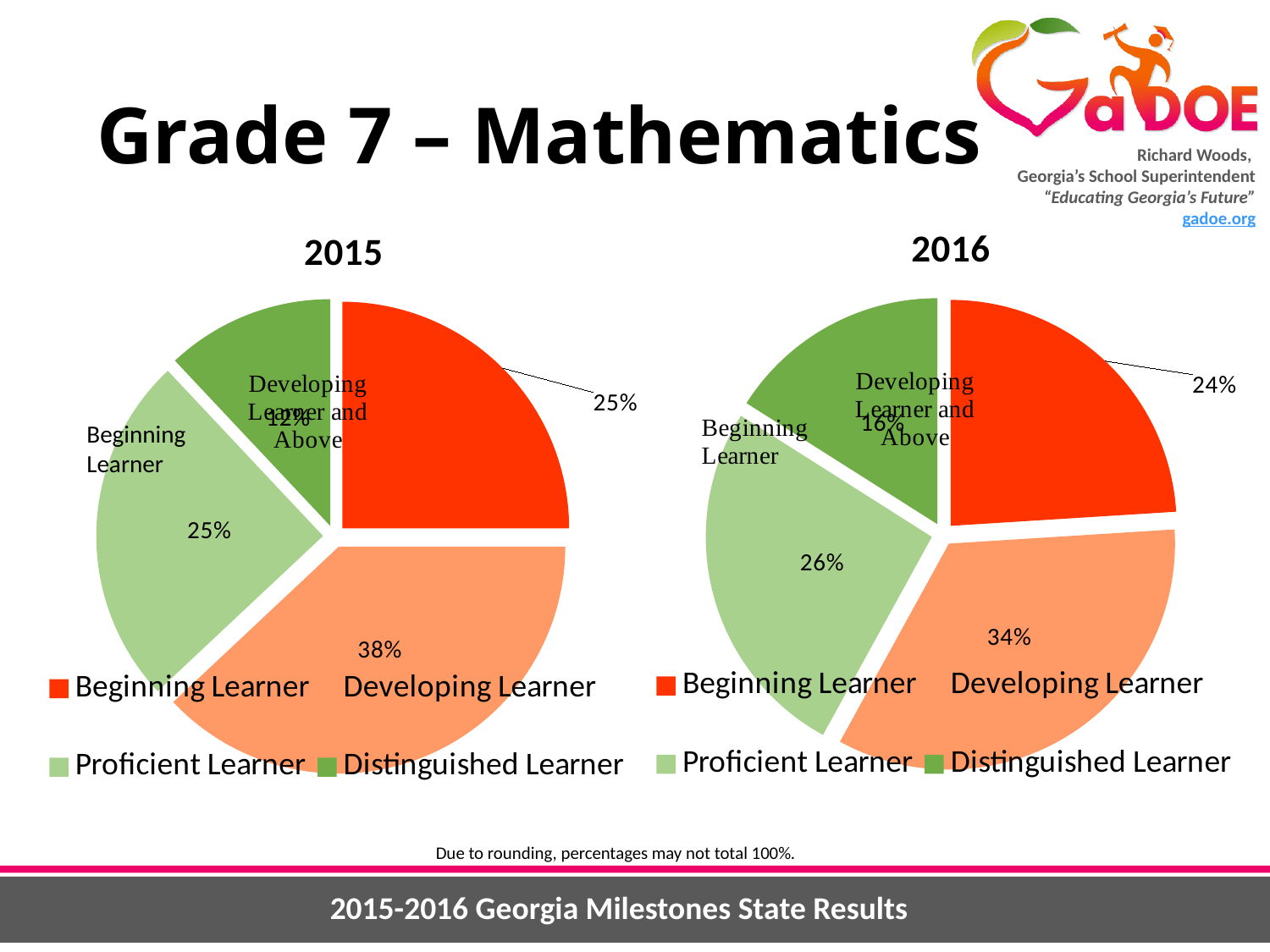
How many categories does the legend of the 2016 pie chart list? 4 What colour represents Beginning Learner in the legends of both charts? Red In the 2016 pie chart, what is the combined share of Developing Learner and Distinguished Learner? 50% In the 2016 pie chart, what percentage is shown for Beginning Learner? 24% In the 2015 pie chart, what percentage is shown for Distinguished Learner? 12% In the 2016 pie chart, which category has the smallest share? Distinguished Learner In the 2015 pie chart, what percentage is shown for Developing Learner? 38% What is the difference between the Developing Learner percentage in 2015 and in 2016? 4 percentage points Is the Proficient Learner share larger in the 2015 chart or the 2016 chart? 2016 In the 2016 pie chart, what percentage is shown for Distinguished Learner? 16% What type of chart is used to show the 2015 results? Pie chart In the 2015 pie chart, which category has the largest share? Developing Learner